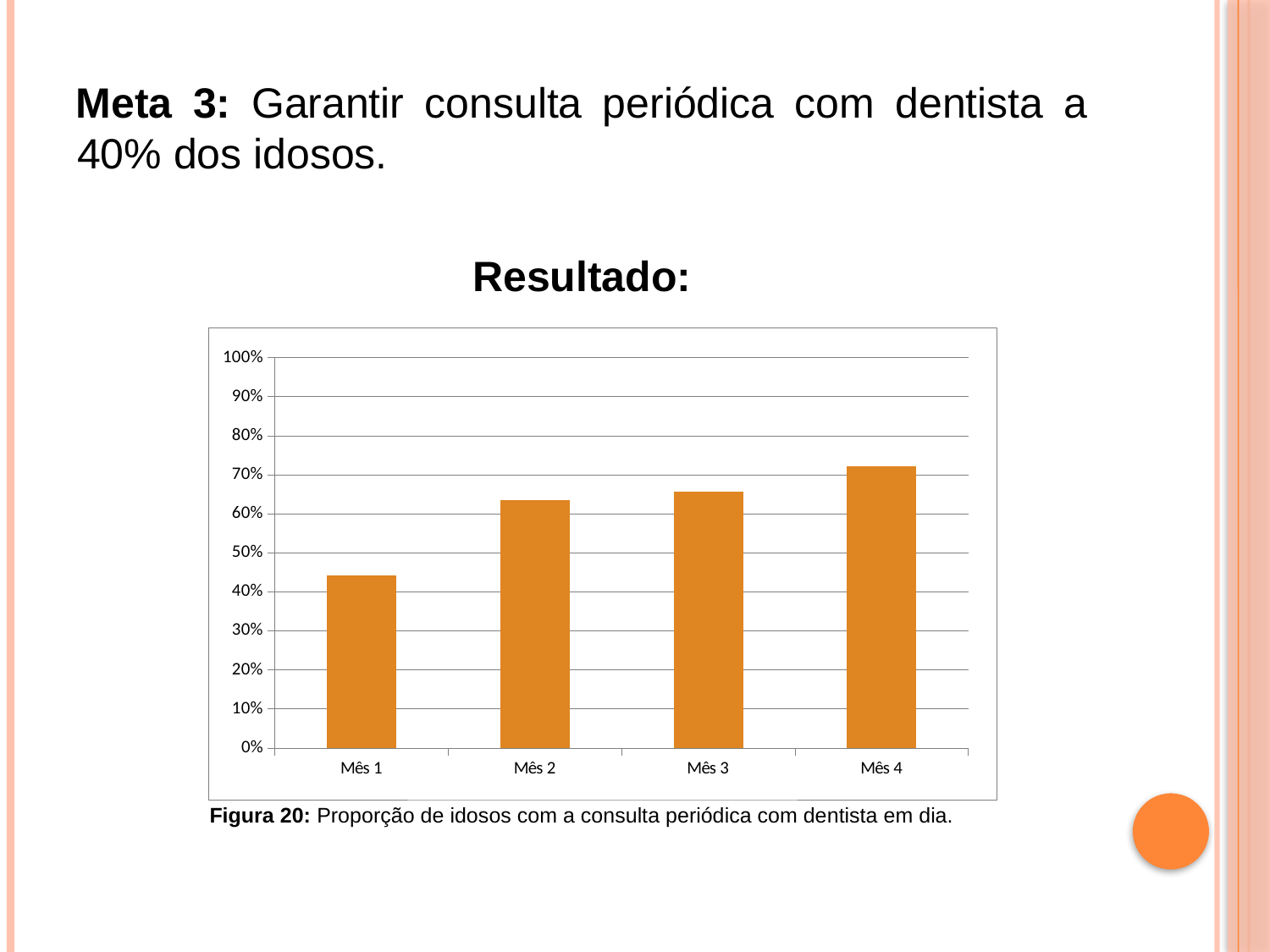
Do the values rise or fall from Mês 1 to Mês 4? rise Is the value for Mês 4 greater or less than 70%? greater Which month has the lowest bar in the chart? Mês 1 How many categories (months) are shown on the x axis of the chart? 4 Is the value for Mês 2 greater or less than 60%? greater Is the value for Mês 1 greater or less than 50%? less What kind of chart is shown on the slide? bar chart Which month has the highest bar in the chart? Mês 4 Which is larger, the value for Mês 1 or the value for Mês 4? Mês 4 What is the figure number given in the caption below the chart? Figura 20